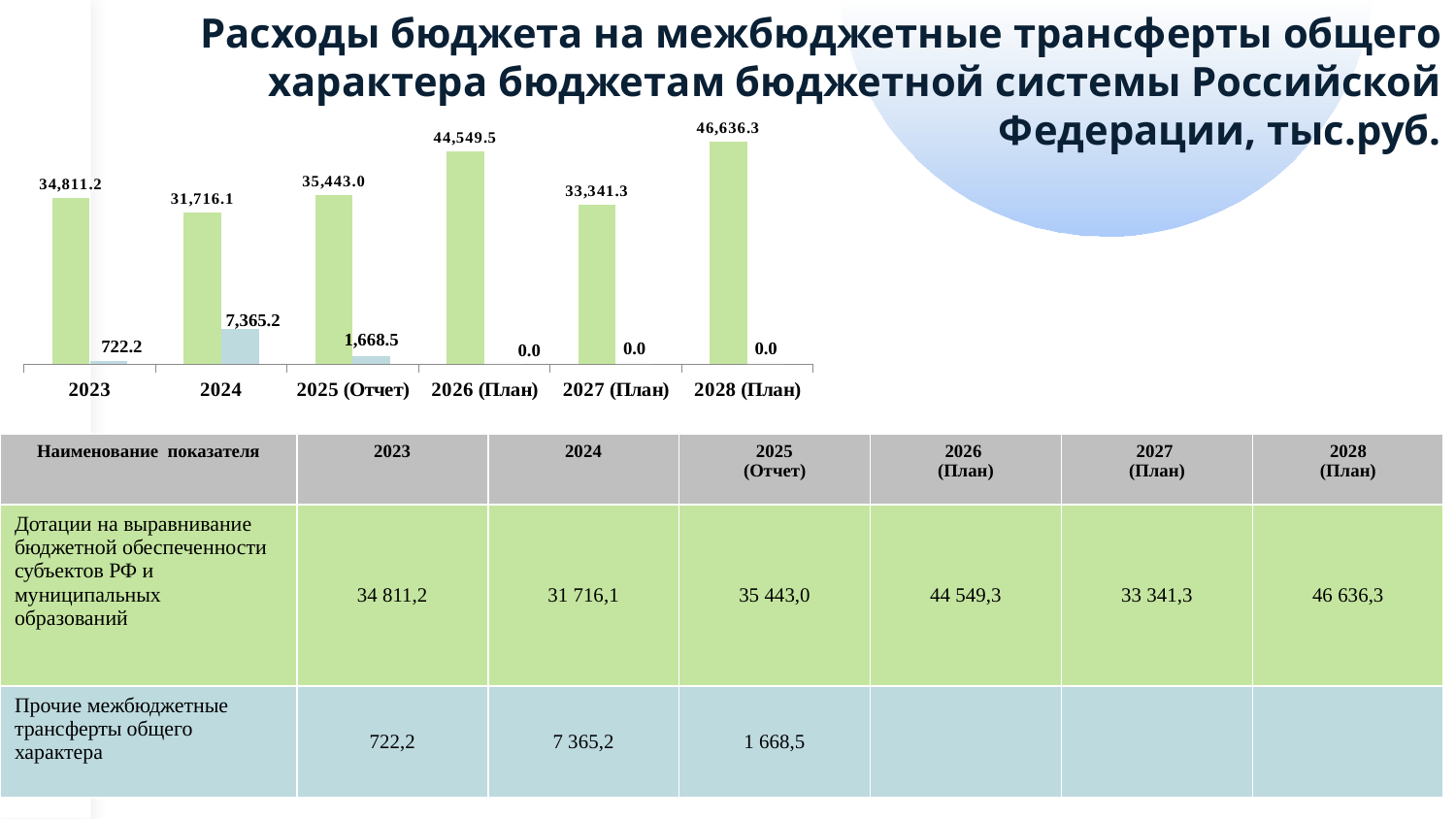
Which year has the larger green bar value: 2023 or 2027 (План)? 2023 In which year is the green bar (Дотации на выравнивание) the lowest? 2024 In which year is the light blue bar (Прочие межбюджетные трансферты) the highest? 2024 What is the difference between the light blue bar values for 2024 and 2023? 6,643.0 What type of chart is shown on the slide? Bar chart How many years (categories) are shown on the x axis of the chart? 6 What is the value of the green bar (Дотации на выравнивание бюджетной обеспеченности) for 2023? 34,811.2 In which year is the green bar (Дотации на выравнивание) the highest? 2028 (План) What is the difference between the green bar values for 2025 (Отчет) and 2024? 3,726.9 What is the value of the light blue bar (Прочие межбюджетные трансферты общего характера) for 2024? 7,365.2 What is the value of the light blue bar (Прочие межбюджетные трансферты общего характера) for 2026 (План)? 0.0 What is the value of the light blue bar (Прочие межбюджетные трансферты общего характера) for 2025 (Отчет)? 1,668.5